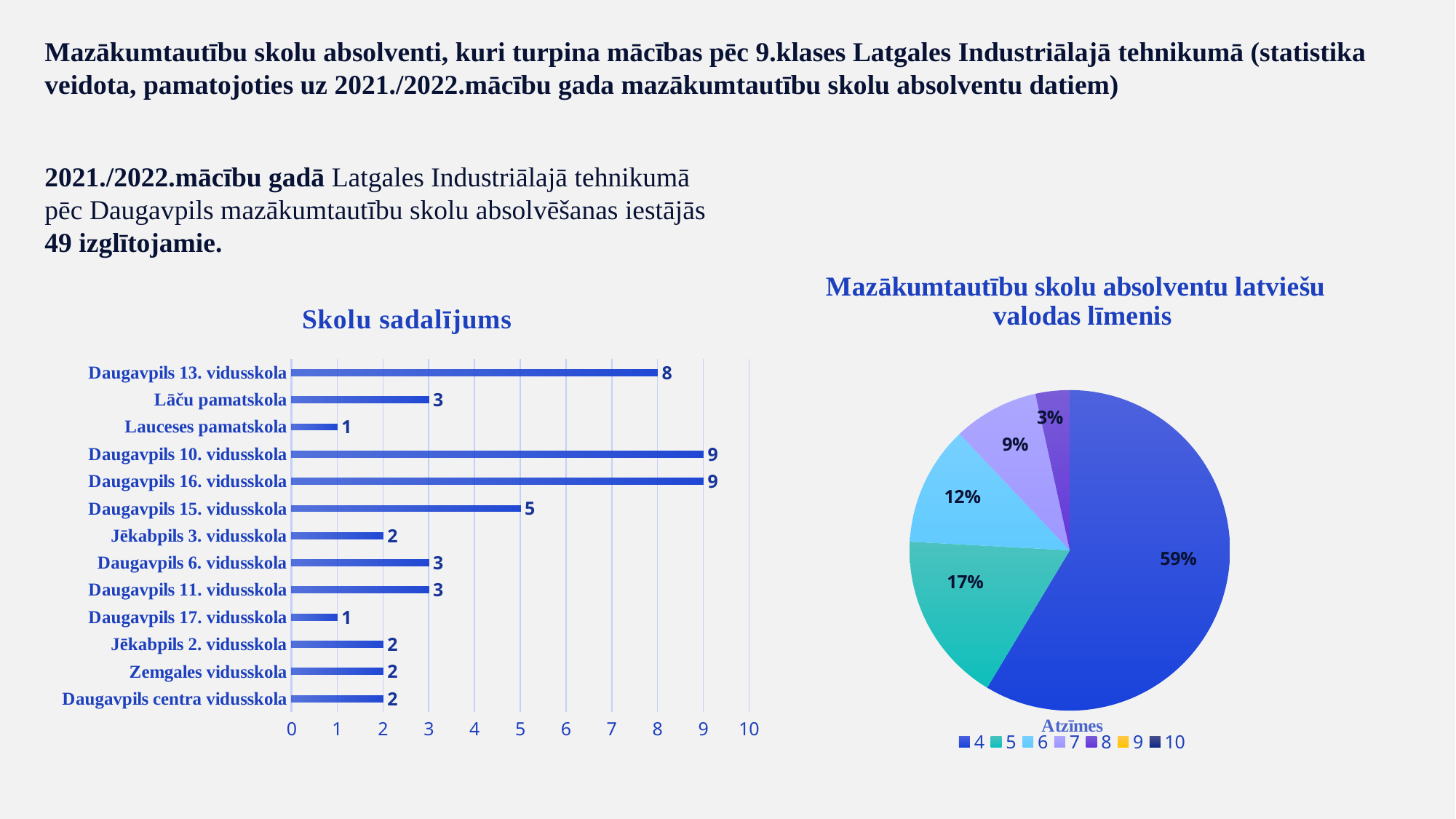
How many entries does the legend of the pie chart 'Mazākumtautību skolu absolventu latviešu valodas līmenis' list? 7 In the 'Skolu sadalījums' bar chart, what is the value for Daugavpils 13. vidusskola? 8 What type of chart is 'Skolu sadalījums'? bar chart In the 'Skolu sadalījums' bar chart, what is the value for Daugavpils 15. vidusskola? 5 In the 'Skolu sadalījums' bar chart, which is larger: Daugavpils 13. vidusskola or Daugavpils 15. vidusskola? Daugavpils 13. vidusskola In the pie chart 'Mazākumtautību skolu absolventu latviešu valodas līmenis', what share does grade 6 have? 12% In the 'Skolu sadalījums' bar chart, what is the value for Lauceses pamatskola? 1 In the pie chart 'Mazākumtautību skolu absolventu latviešu valodas līmenis', what share does grade 4 have? 59% In the pie chart 'Mazākumtautību skolu absolventu latviešu valodas līmenis', which grade has the largest slice? 4 In the 'Skolu sadalījums' bar chart, what is the difference between Daugavpils 10. vidusskola and Lāču pamatskola? 6 How many schools are listed in the 'Skolu sadalījums' bar chart? 13 What is the legend title of the pie chart 'Mazākumtautību skolu absolventu latviešu valodas līmenis'? Atzīmes